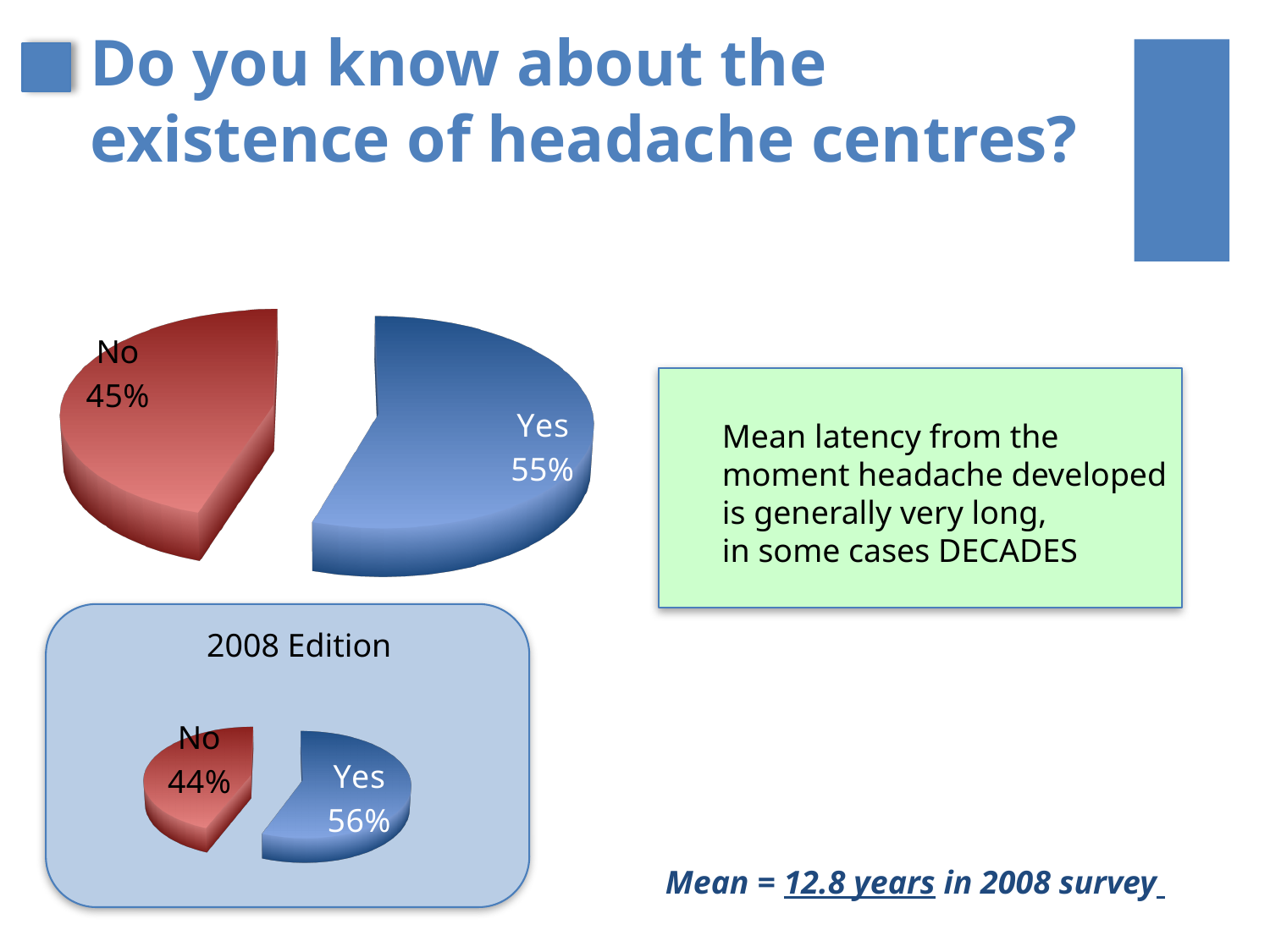
What type of chart is used on this slide? Pie chart In the 2008 Edition pie chart, what percentage answered Yes? 56% How many slices does the 2008 Edition pie chart have? 2 In the larger pie chart at the top left, what percentage answered Yes? 55% In the 2008 Edition pie chart, which slice is the smallest? No In the 2008 Edition pie chart, what percentage answered No? 44% In the larger pie chart at the top left, what percentage answered No? 45% Is the Yes share larger in the top-left pie chart or in the 2008 Edition pie chart? 2008 Edition In the larger pie chart at the top left, which slice is the largest? Yes In the larger pie chart at the top left, what is the difference in percentage points between Yes and No? 10 In the 2008 Edition pie chart, what colour is the Yes slice? Blue In the 2008 Edition pie chart, what is the difference in percentage points between Yes and No? 12